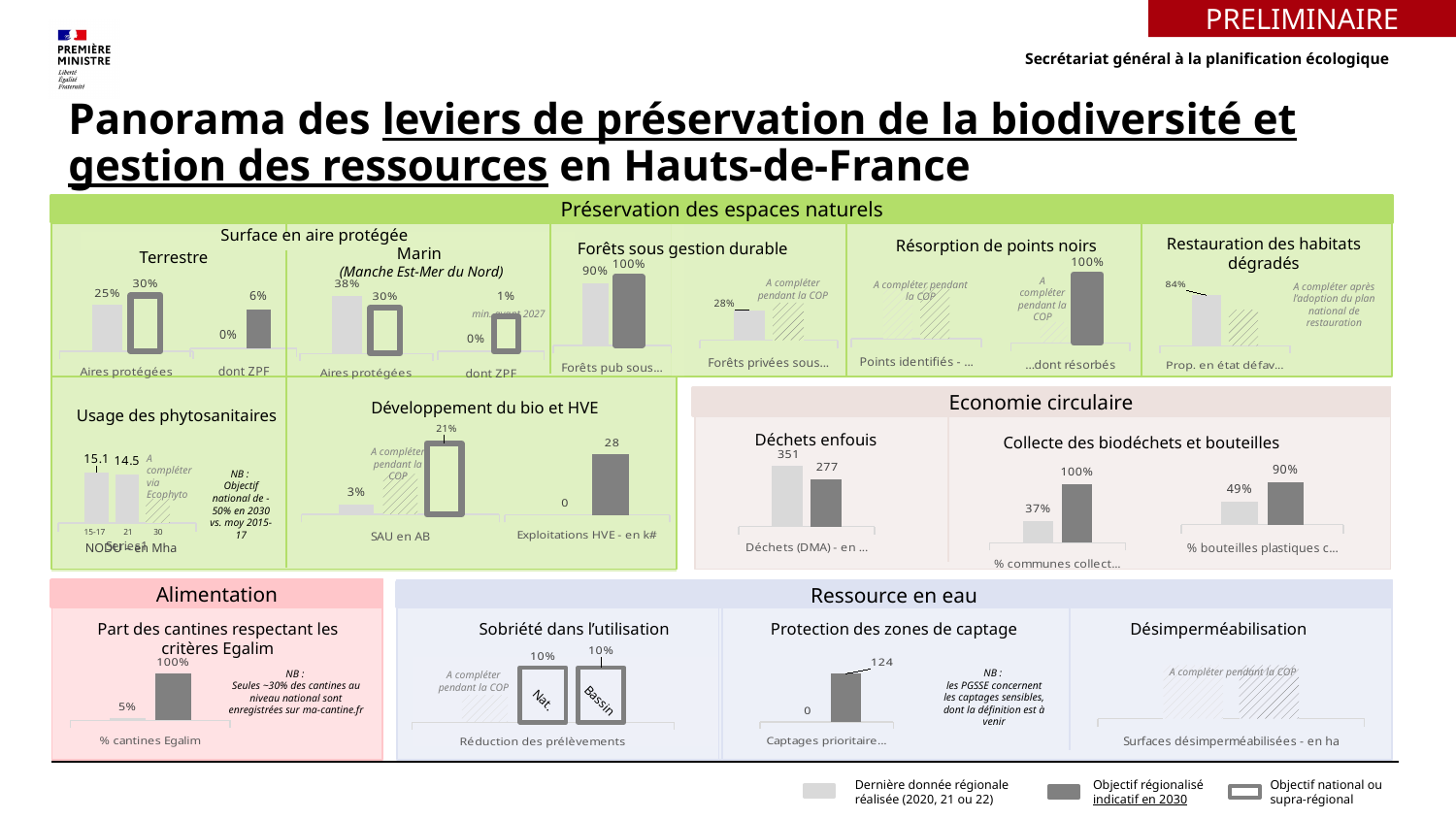
In the 'Développement du bio et HVE' chart, what is the 2030 objective for Exploitations HVE - en k#? 28 In the 'Déchets enfouis' chart, what is the difference between the two values shown for Déchets (DMA)? 74 In the 'Surface en aire protégée - Terrestre' chart, what is the 2030 objective value for dont ZPF? 6% In the 'Usage des phytosanitaires' chart, what is the latest regional value for NODU en Mha? 14.5 In the 'Part des cantines respectant les critères Egalim' chart, what is the value of the dark grey bar (objectif régionalisé 2030) for % cantines Egalim? 100% In the 'Collecte des biodéchets et bouteilles' chart, what is the difference between the 2030 objective and the latest regional value for % communes collect...? 63% In the 'Protection des zones de captage' chart, what is the 2030 objective value for Captages prioritaires? 124 What kind of chart is used in the 'Forêts sous gestion durable' panel? bar chart In the 'Collecte des biodéchets et bouteilles' chart, what is the light grey value for % bouteilles plastiques? 49% In the 'Part des cantines respectant les critères Egalim' chart, what is the value of the light grey bar for % cantines Egalim? 5% In the 'Déchets enfouis' chart, what is the value of the light grey bar (dernière donnée régionale) for Déchets (DMA)? 351